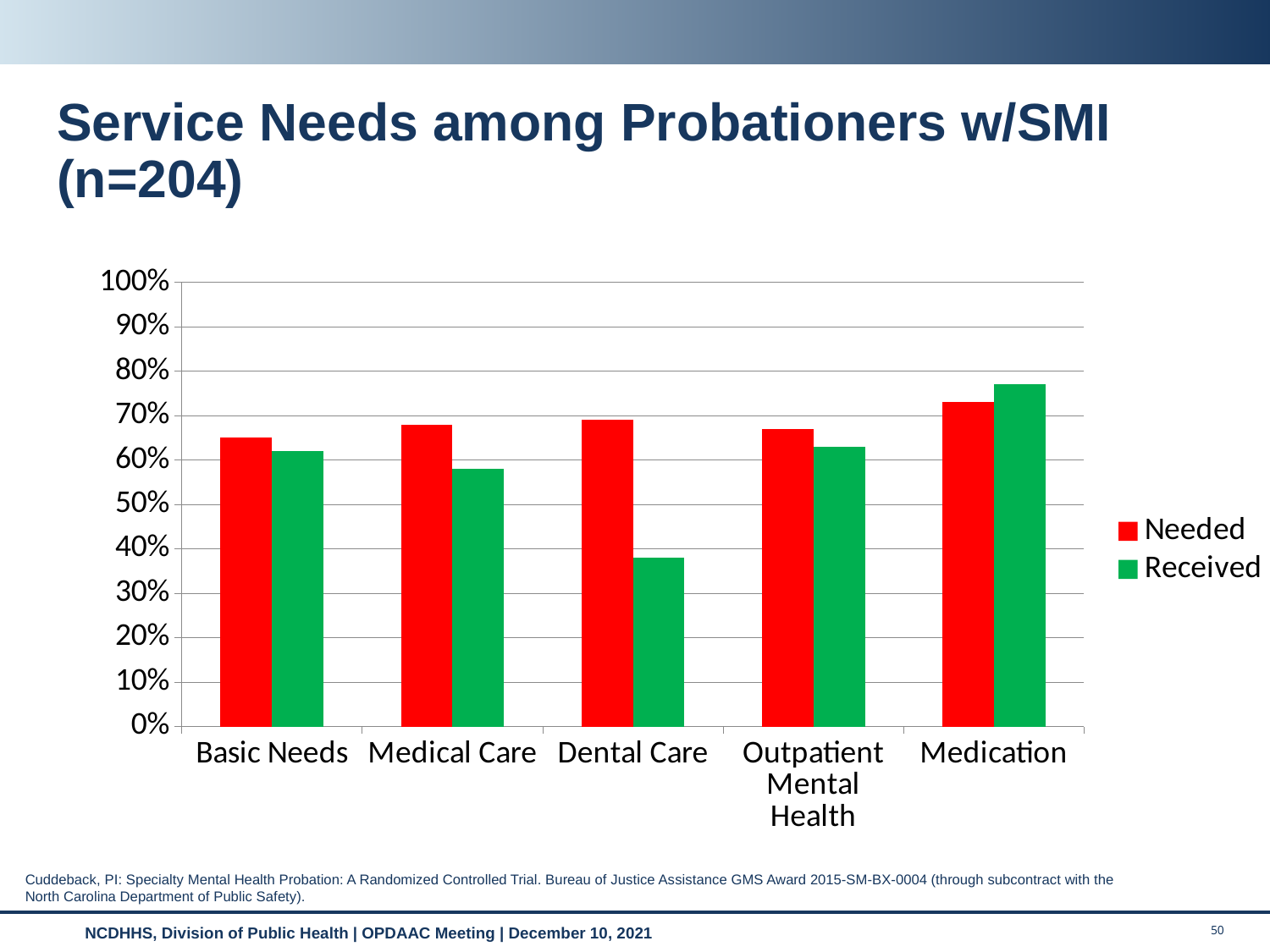
What kind of chart is shown on the slide? Bar chart How many service categories are shown on the x axis? 5 How many series does the legend list? 2 Which service category has the highest Received value? Medication For Medication, which is larger: Needed or Received? Received Which service category has the lowest Received value? Dental Care Is the Received value for Medication greater or less than 70%? greater Is the Received value for Dental Care greater or less than 50%? less Which service category has the highest Needed value? Medication For Dental Care, which is larger: Needed or Received? Needed Is the Needed value for Basic Needs greater or less than 60%? greater What colour are the Received bars? Green